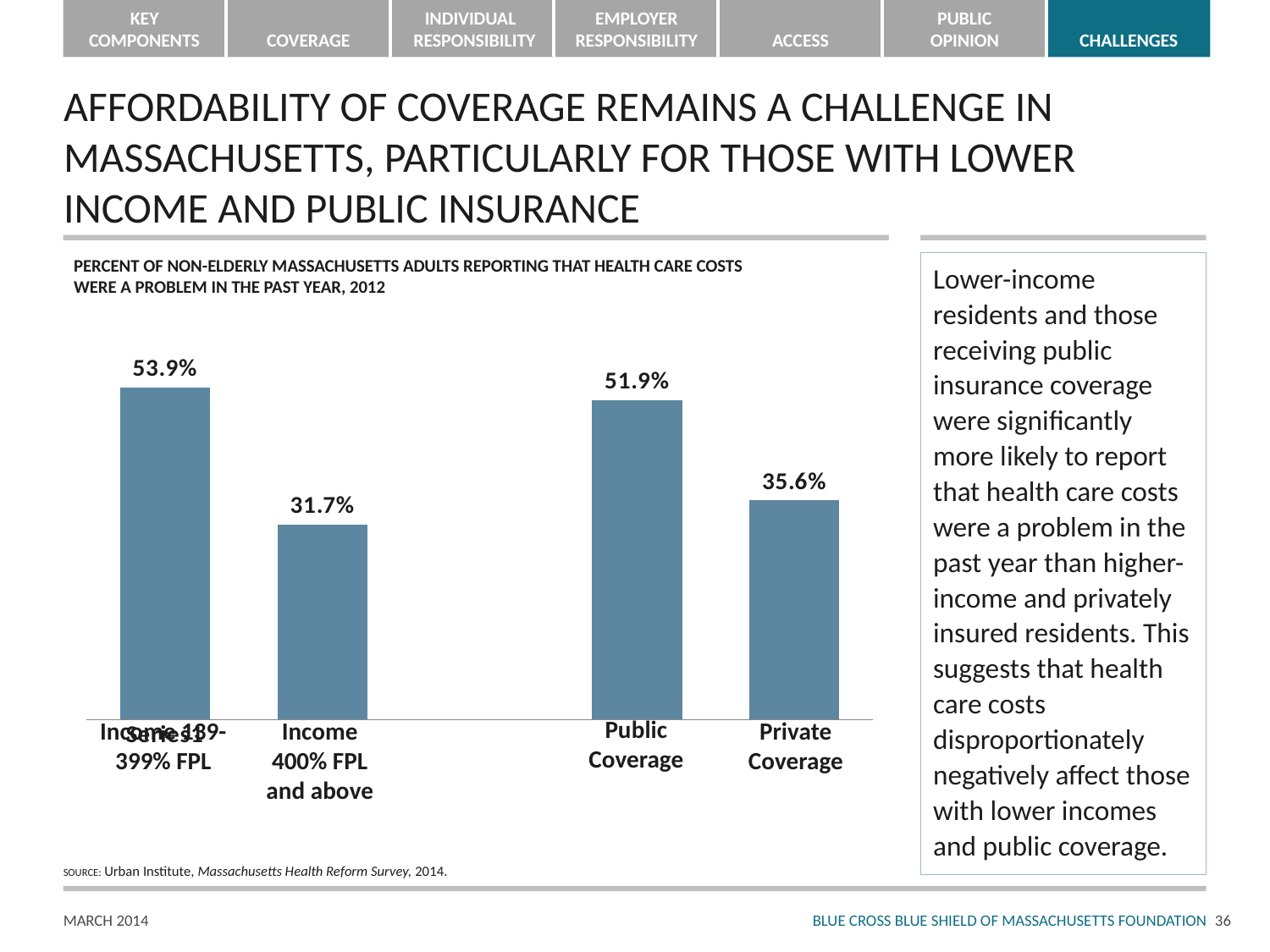
What type of chart is shown on the slide? Bar chart What is the difference in percentage points between Public Coverage and Private Coverage? 16.3 Which category has the lowest percentage reporting health care costs were a problem? Income 400% FPL and above What is the value shown for the Income 139-399% FPL group? 53.9% What is the value shown for Private Coverage? 35.6% What percent of non-elderly Massachusetts adults with income 400% FPL and above reported that health care costs were a problem in the past year? 31.7% Which is larger, the value for Public Coverage or the value for Private Coverage? Public Coverage How many bars are plotted in the chart? 4 What year does the chart's data refer to, according to the chart heading? 2012 Which category has the highest percentage reporting health care costs were a problem? Income 139-399% FPL What is the value shown for Public Coverage? 51.9% What is the difference in percentage points between the Income 139-399% FPL group and the Income 400% FPL and above group? 22.2